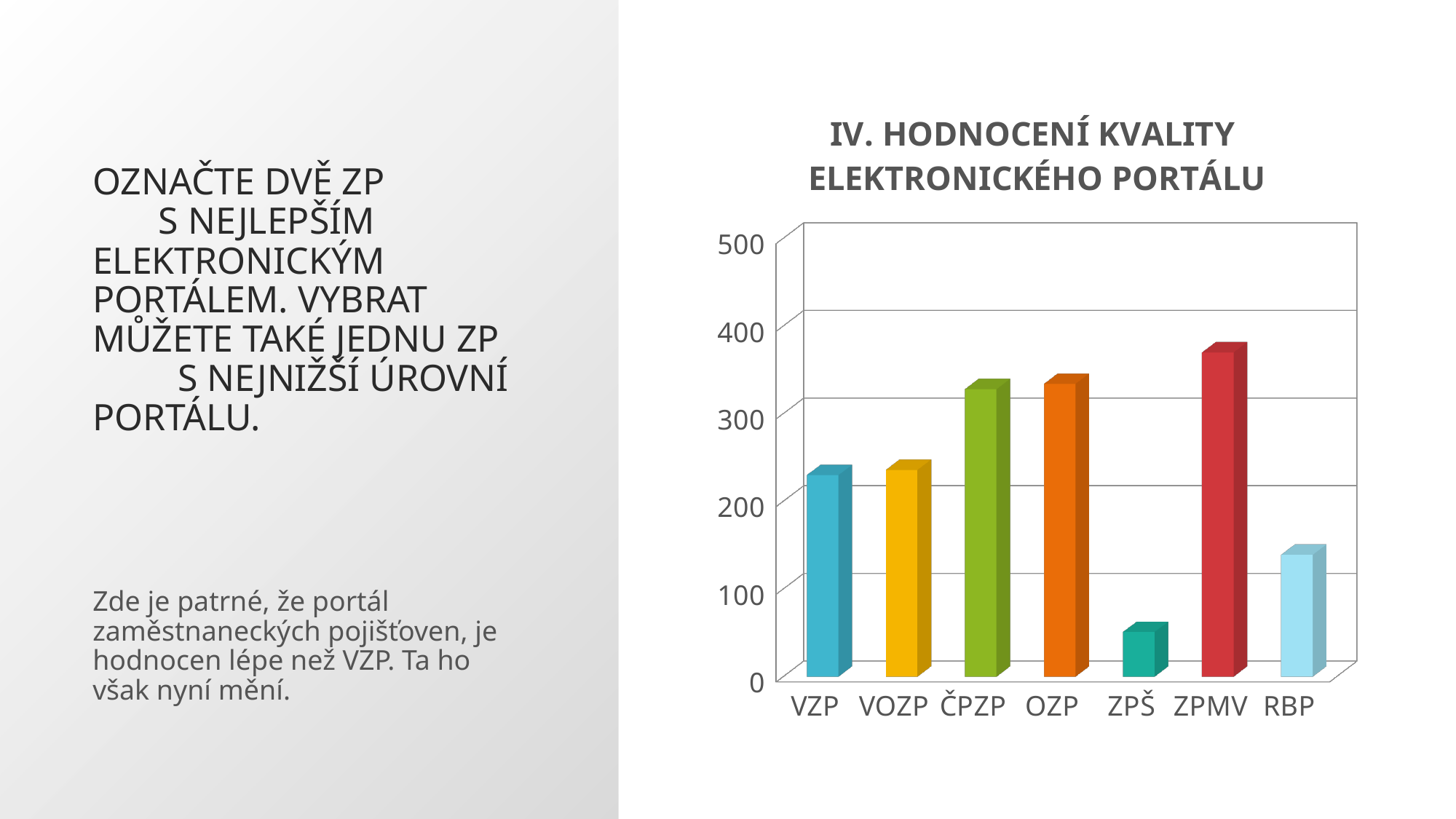
Is the value for RBP greater or less than 100? greater Which has a larger value, VZP or ČPZP? ČPZP Which has a larger value, ZPMV or RBP? ZPMV How many categories are shown on the x axis of the chart? 7 Is the value for VZP greater or less than 200? greater Is the value for ZPŠ greater or less than 100? less Which category has the lowest value in the chart? ZPŠ What type of chart is shown on the slide? bar chart What colour is the bar for ZPMV? red Which category has the highest value in the chart? ZPMV What is the title of the chart? IV. HODNOCENÍ KVALITY ELEKTRONICKÉHO PORTÁLU